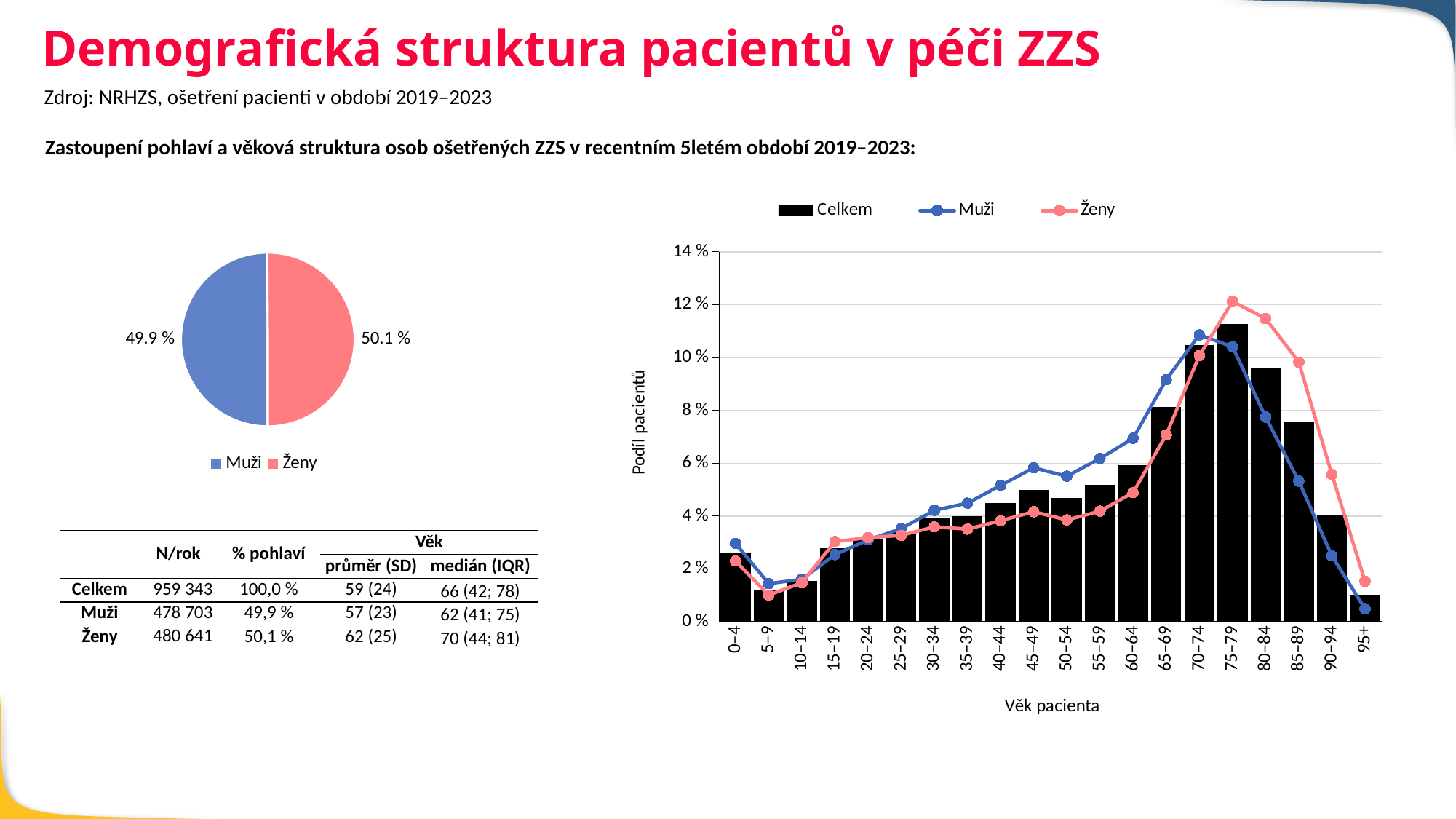
In the pie chart on the left, what share is shown for Ženy? 50.1 % In the pie chart on the left, what share is shown for Muži? 49.9 % In the chart on the right, which age category has the highest Celkem bar? 75–79 In the chart on the right, what is the label of the y axis? Podíl pacientů In the chart on the right, at which age category does the Muži line reach its highest point? 70–74 In the pie chart on the left, how many entries does the legend list? 2 In the chart on the right, is the Celkem value for 75–79 greater or less than 10 %? greater In the chart on the right, at which age category does the Ženy line reach its highest point? 75–79 In the chart on the right, how many age categories are shown on the x axis? 20 In the pie chart on the left, which slice is larger, Muži or Ženy? Ženy In the chart on the right, how many series does the legend list? 3 In the chart on the right, which is larger at 85–89, the Muži value or the Ženy value? Ženy